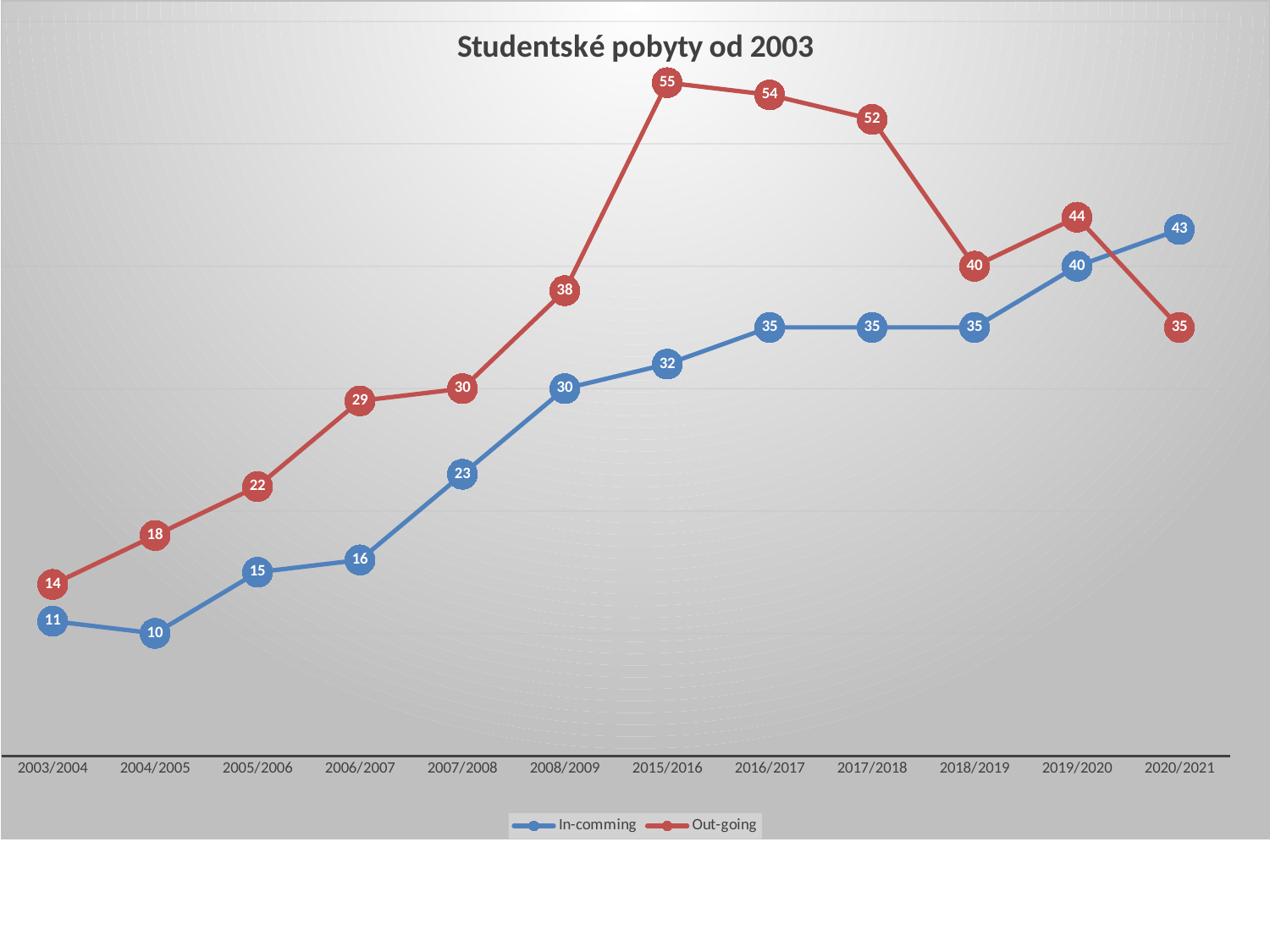
Which category has the lowest In-comming value? 2004/2005 Which category has the highest Out-going value? 2015/2016 What kind of chart is this? line chart Does the In-comming series generally rise or fall from 2004/2005 to 2020/2021? rise What is the Out-going value for 2015/2016? 55 What is the difference between the Out-going and In-comming values for 2017/2018? 17 How many categories are shown on the x axis? 12 What is the In-comming value for 2008/2009? 30 What is the In-comming value for 2020/2021? 43 How many series does the legend list? 2 What is the title of the chart? Studentské pobyty od 2003 Which is larger for 2020/2021, In-comming or Out-going? In-comming